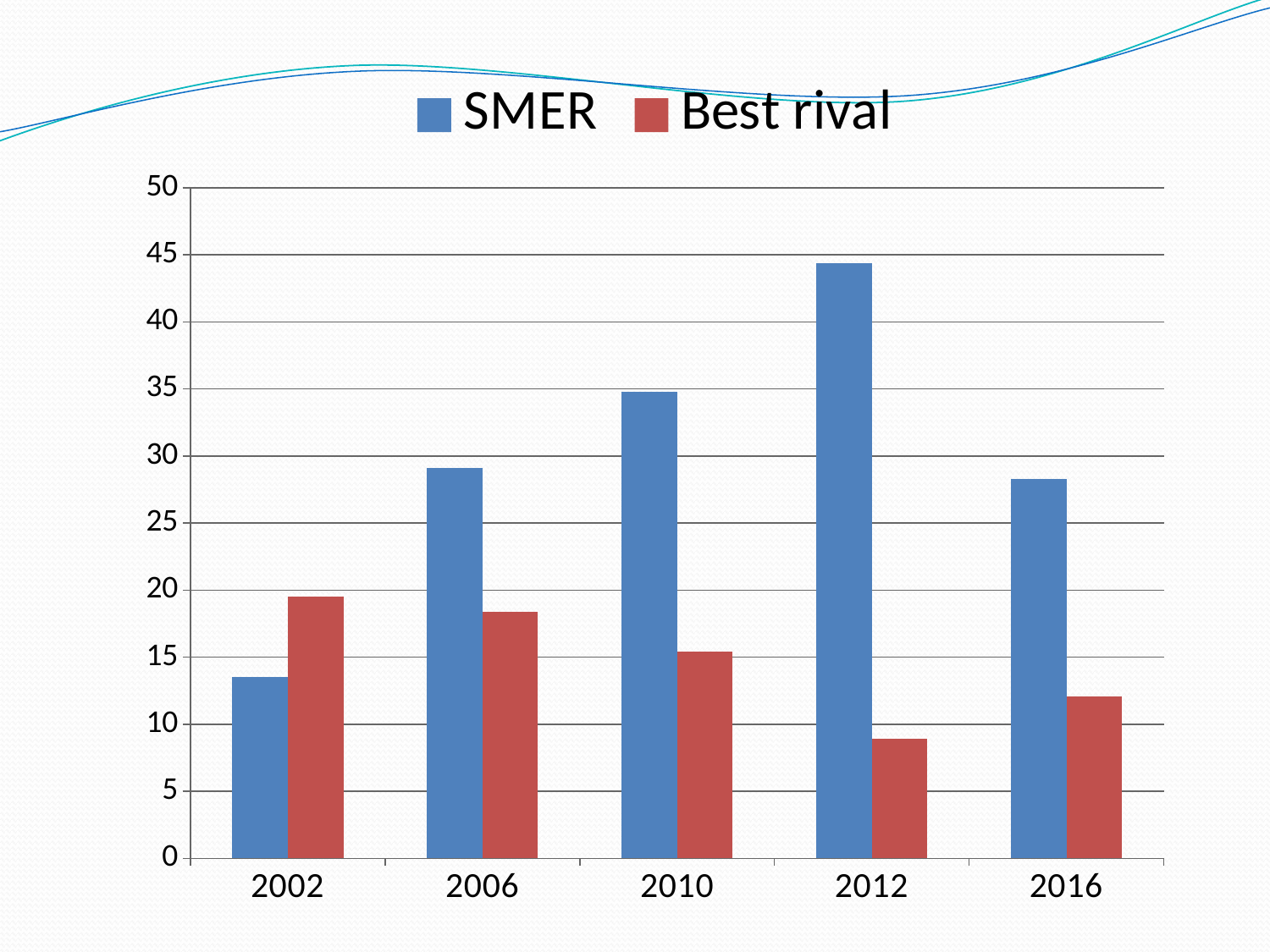
In which year is the Best rival value lowest? 2012 In which year is the Best rival value highest? 2002 In which year is the SMER value lowest? 2002 In which year is the SMER value highest? 2012 Which colour represents SMER in the legend? blue What kind of chart is shown on the slide? bar chart How many series does the legend list? 2 In 2002, which is larger: SMER or Best rival? Best rival Is the Best rival value for 2012 greater or less than 10? less Is the SMER value for 2012 greater or less than 40? greater Does the SMER value rise or fall from 2002 to 2012? rise How many years are shown on the x axis? 5